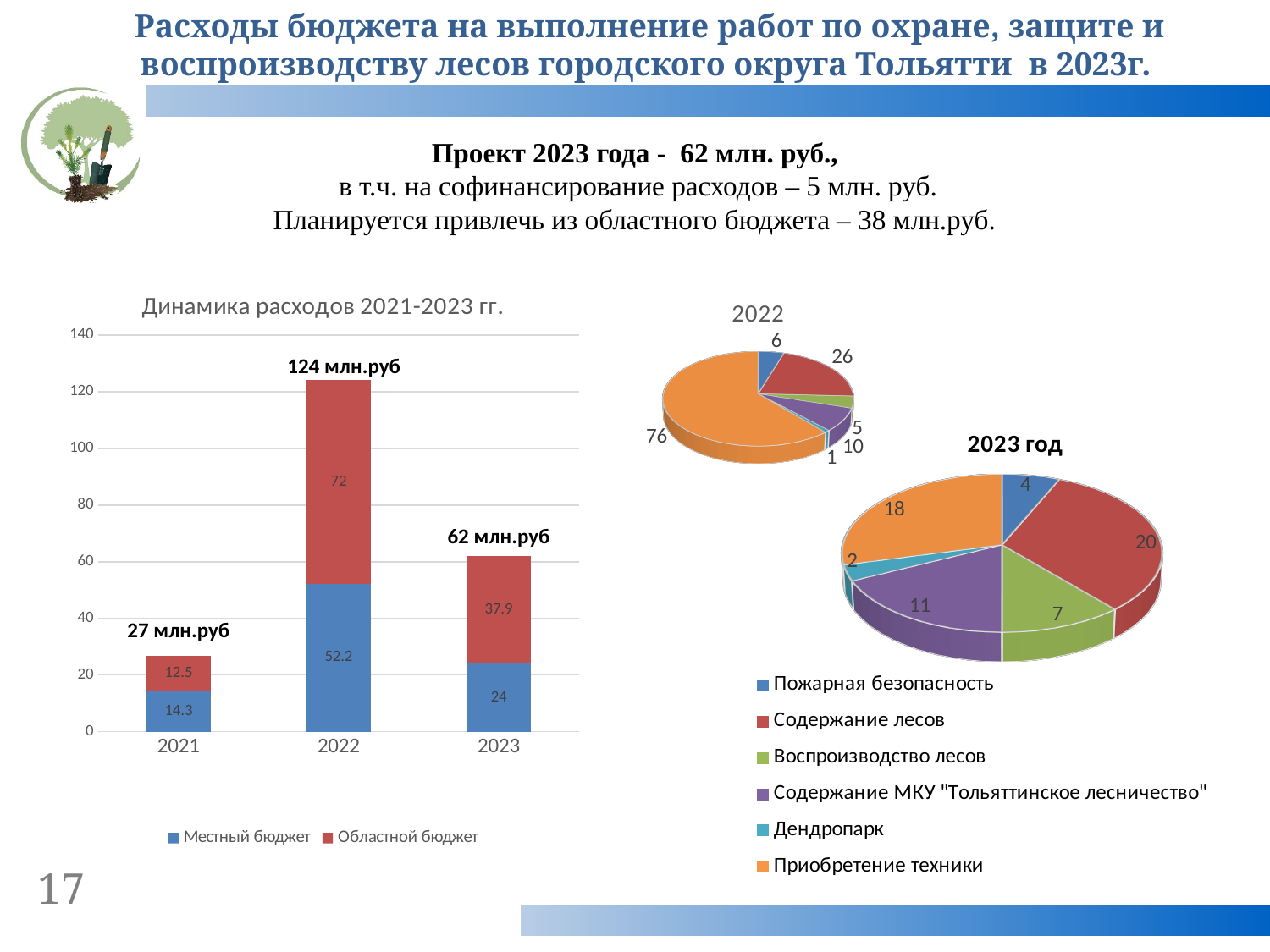
In the pie chart '2022', what is the value for Приобретение техники? 76 In the bar chart 'Динамика расходов 2021-2023 гг.', which is larger in 2021: Местный бюджет or Областной бюджет? Местный бюджет In the bar chart 'Динамика расходов 2021-2023 гг.', what is the value of Областной бюджет for 2023? 37.9 In the pie chart '2023 год', what is the value for Содержание лесов? 20 In the bar chart 'Динамика расходов 2021-2023 гг.', which year has the highest total expenditure? 2022 In the bar chart 'Динамика расходов 2021-2023 гг.', how many series does the legend list? 2 In the pie chart '2023 год', how many categories are shown? 6 In the bar chart 'Динамика расходов 2021-2023 гг.', what is the value of Местный бюджет for 2022? 52.2 In the pie chart '2022', which category has the smallest value? Дендропарк In the bar chart 'Динамика расходов 2021-2023 гг.', what is the difference between Областной бюджет and Местный бюджет in 2022? 19.8 In the bar chart 'Динамика расходов 2021-2023 гг.', what total label is shown above the 2021 bar? 27 млн.руб What type of chart is 'Динамика расходов 2021-2023 гг.'? Stacked bar chart